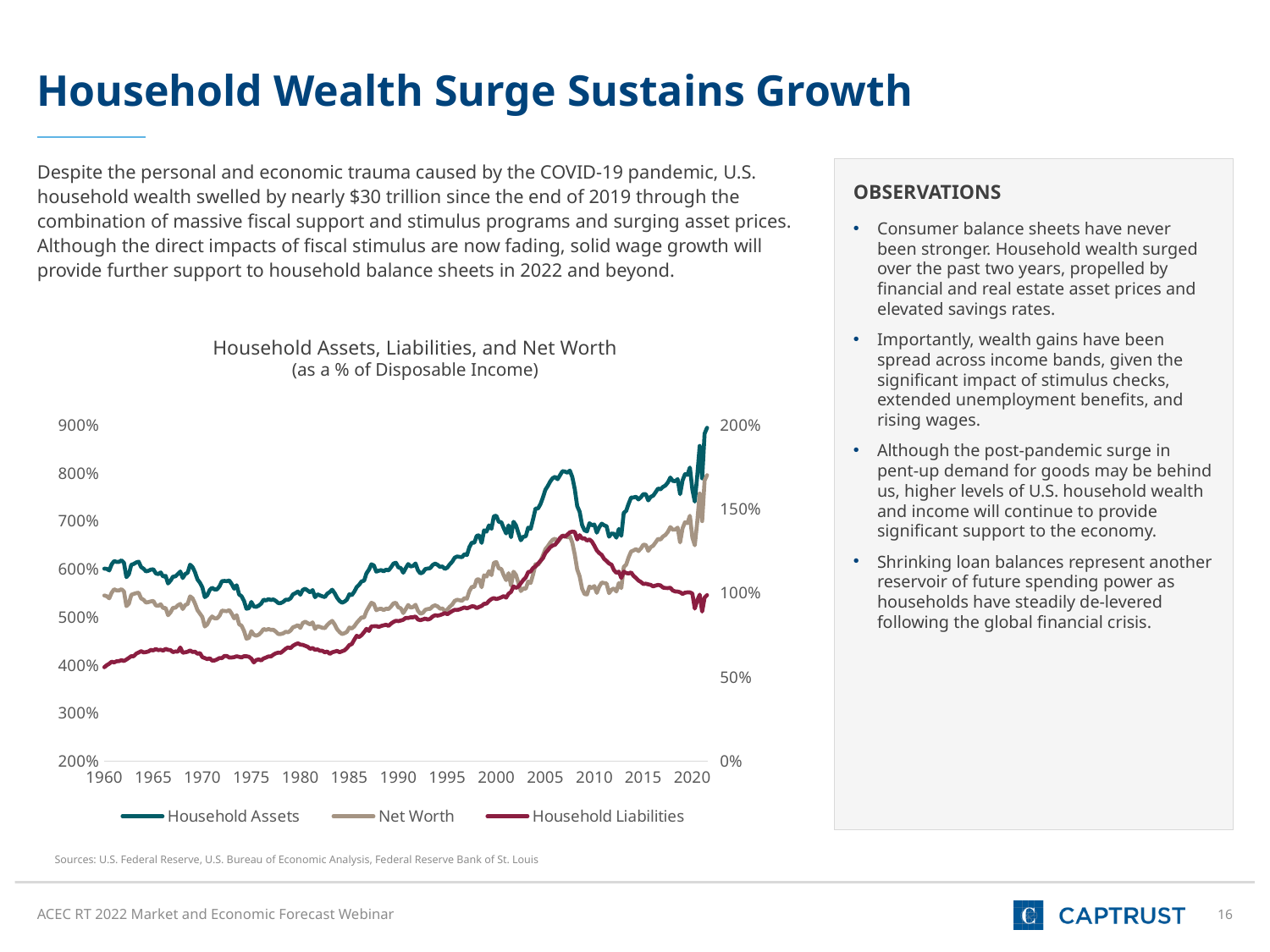
What kind of chart is shown on the slide? Line chart Is the Household Assets value in 1960 greater or less than 500% on the left axis? greater How many series does the chart legend list? 3 Does the Household Assets line overall rise or fall from 1960 to 2020? Rise What is the title of the chart? Household Assets, Liabilities, and Net Worth (as a % of Disposable Income) Which line is higher on the chart in 2000, Household Assets or Net Worth? Household Assets How many year labels are shown along the x axis of the chart? 13 What are the three series listed in the chart legend? Household Assets, Net Worth, Household Liabilities Does the Household Liabilities line rise or fall between 2010 and 2020? Fall Which series is plotted lowest on the chart across the whole period? Household Liabilities Is the Household Liabilities value in 1960 greater or less than 100% on the right axis? less Which series is plotted highest on the chart across the whole period? Household Assets